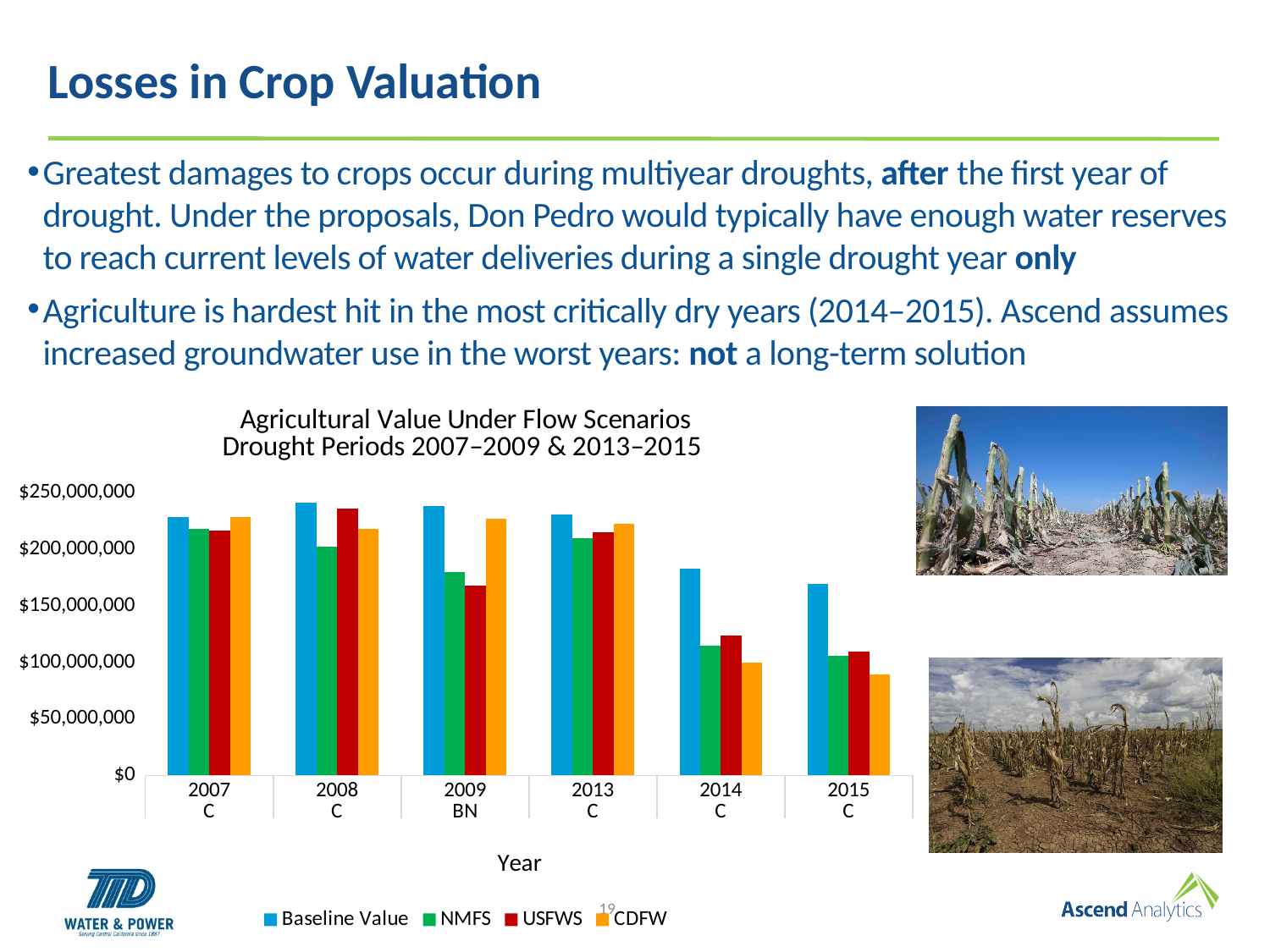
Do the Baseline Value bars rise or fall from 2013 to 2015? fall What kind of chart is shown on the slide? bar chart Which series has the lowest value in 2009? USFWS Is the NMFS value for 2009 greater or less than $200,000,000? less How many year categories are shown on the x axis of the chart? 6 Is the CDFW value for 2015 greater or less than $100,000,000? less In which year is the Baseline Value lowest? 2015 Which series has the highest value in 2014? Baseline Value Which is larger, the USFWS value for 2008 or the USFWS value for 2009? 2008 How many series does the chart legend list? 4 Is the Baseline Value for 2014 greater or less than $150,000,000? greater